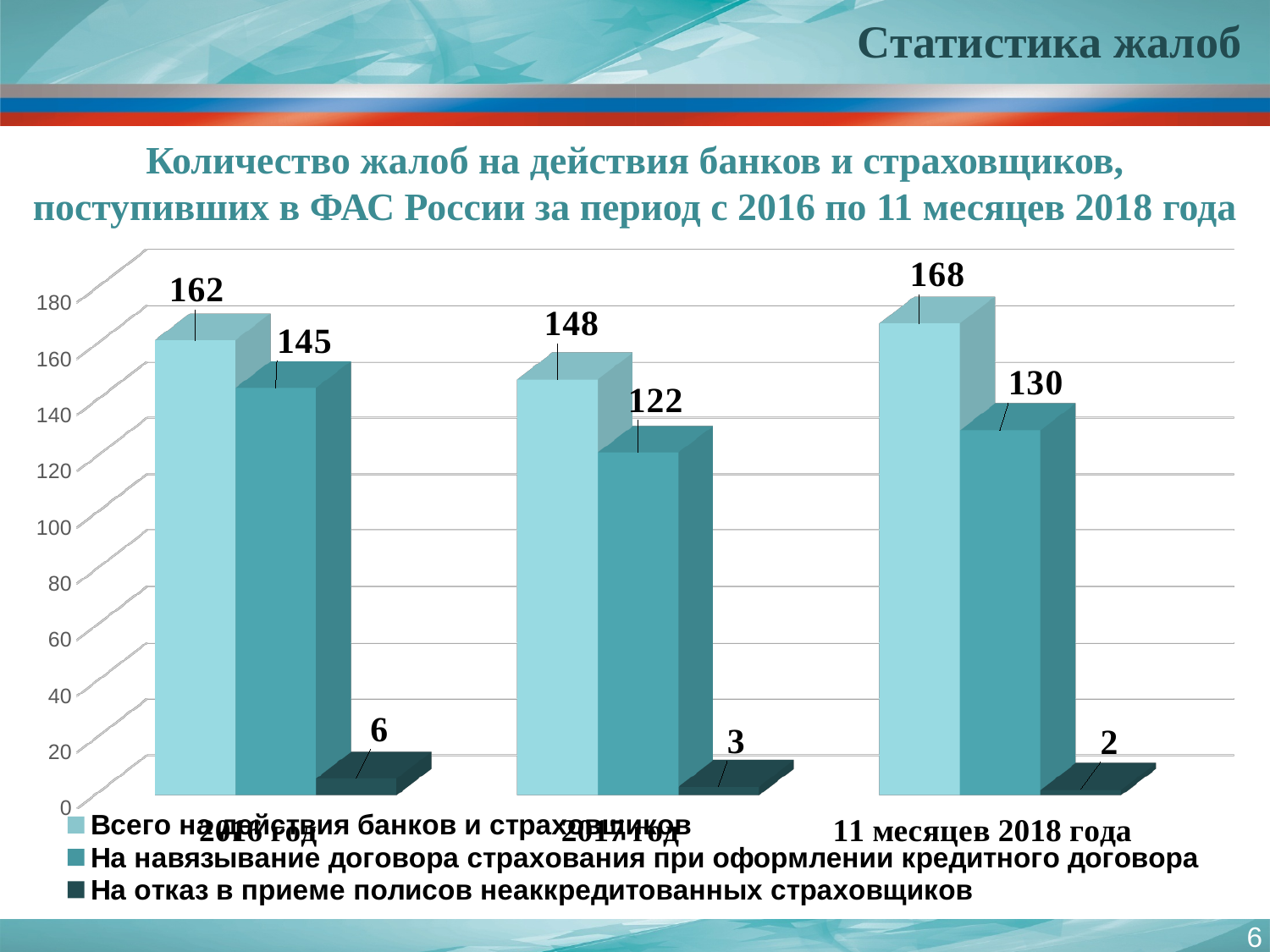
На сколько общее количество жалоб в 2016 году превышает общее количество жалоб в 2017 году? 14 В каком периоде количество жалоб на навязывание договора страхования было наименьшим? 2017 год Как меняется количество жалоб на отказ в приеме полисов неаккредитованных страховщиков от 2016 года к 11 месяцам 2018 года? Снижается Сколько жалоб на отказ в приеме полисов неаккредитованных страховщиков поступило за 11 месяцев 2018 года? 2 На сколько жалоб на навязывание договора страхования в 2016 году больше, чем за 11 месяцев 2018 года? 15 Какого типа эта диаграмма? Столбчатая (bar chart) Сколько жалоб всего на действия банков и страховщиков поступило в 2016 году? 162 В каком периоде общее количество жалоб на действия банков и страховщиков было наибольшим? 11 месяцев 2018 года Сколько жалоб на навязывание договора страхования при оформлении кредитного договора поступило в 2017 году? 122 Где больше жалоб на отказ в приеме полисов неаккредитованных страховщиков: в 2016 году или в 2017 году? 2016 год Сколько периодов (категорий) показано на диаграмме? 3 Сколько рядов данных перечислено в легенде диаграммы? 3